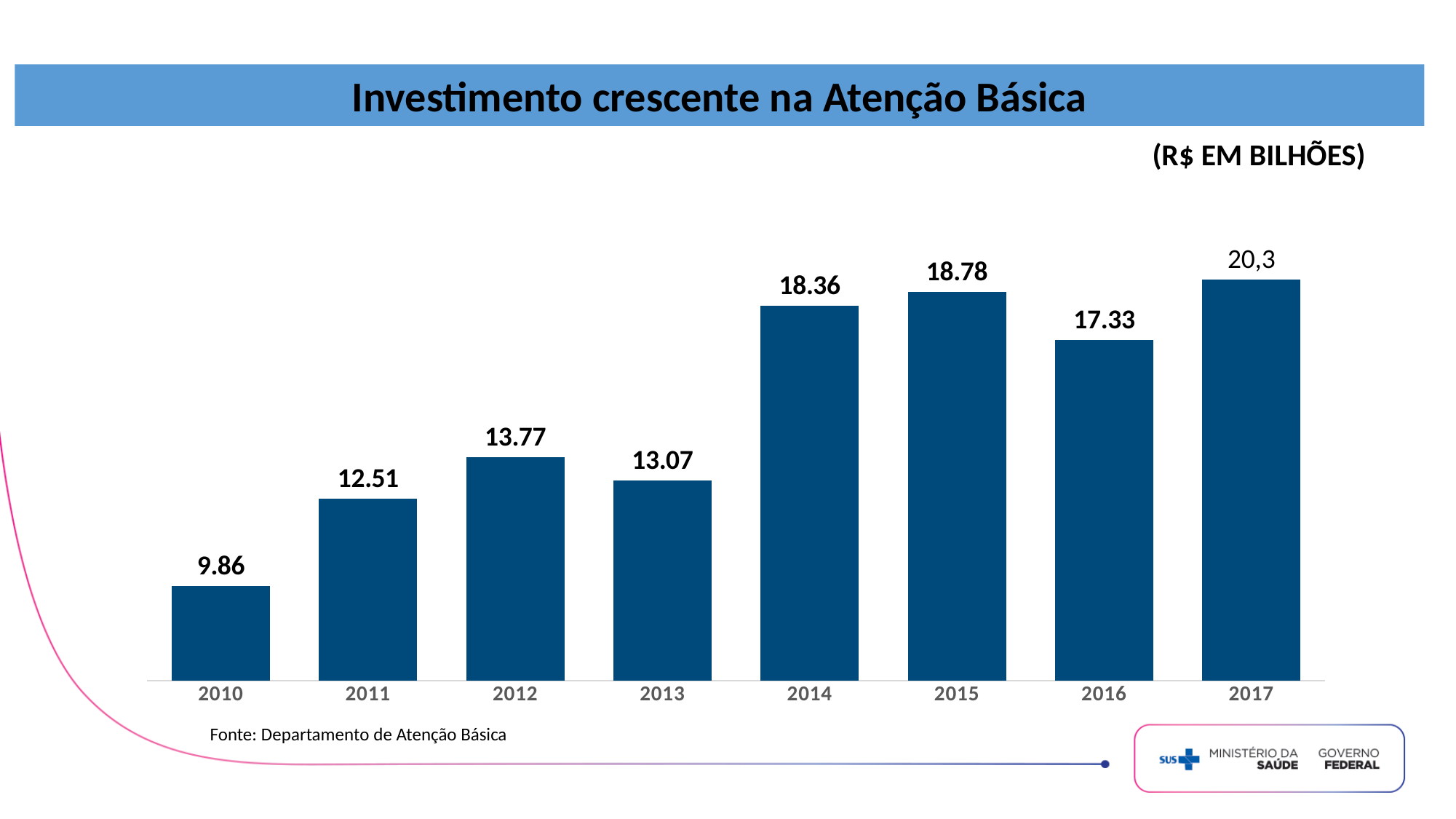
Do the values generally rise or fall from 2010 to 2017? rise What is the difference between the values for 2015 and 2014? 0.42 What kind of chart is shown on the slide? bar chart What is the value for 2010? 9.86 What is the value for 2014? 18.36 What is the value for 2017? 20,3 How many years are shown on the x axis? 8 Which year has the lowest value? 2010 Which is larger, the value for 2016 or the value for 2015? 2015 Which year has the highest value? 2017 What is the difference between the values for 2011 and 2010? 2.65 Which is larger, the value for 2012 or the value for 2013? 2012